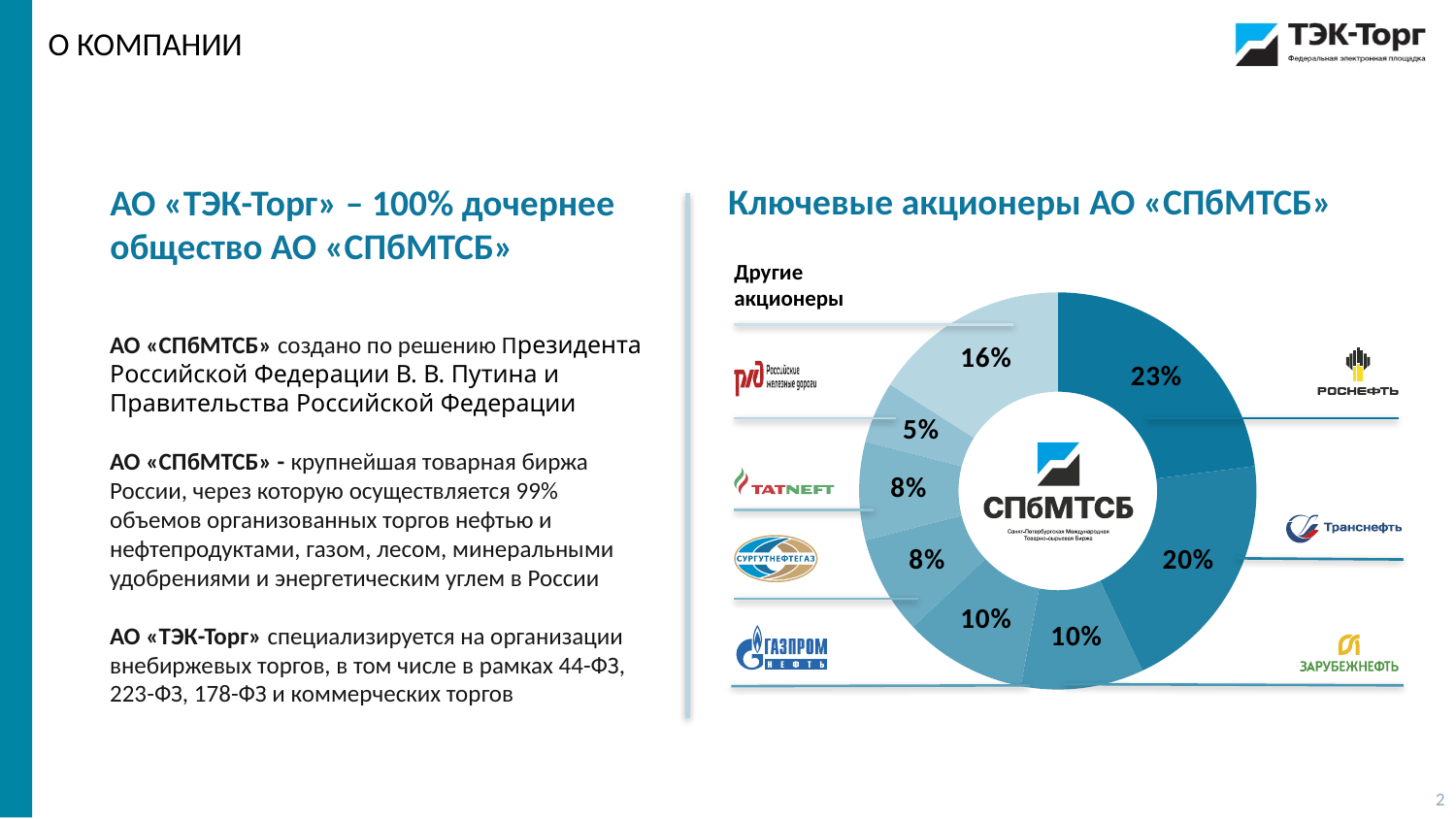
What share is held by Транснефть? 20% What share is attributed to Другие акционеры? 16% Which shareholder has the largest slice in the chart? Роснефть Which is larger: the share of Другие акционеры or the share of Газпром нефть? Другие акционеры What is the difference between the shares of Роснефть and Транснефть? 3% What type of chart is shown on the slide? Pie (donut) chart Which shareholder has the smallest slice in the chart? РЖД How many slices does the chart have? 8 What is the title of the chart on the slide? Ключевые акционеры АО «СПбМТСБ» What share of АО «СПбМТСБ» is held by Роснефть according to the chart? 23% What share is held by РЖД (Российские железные дороги)? 5% What share is held by Татнефть? 8%